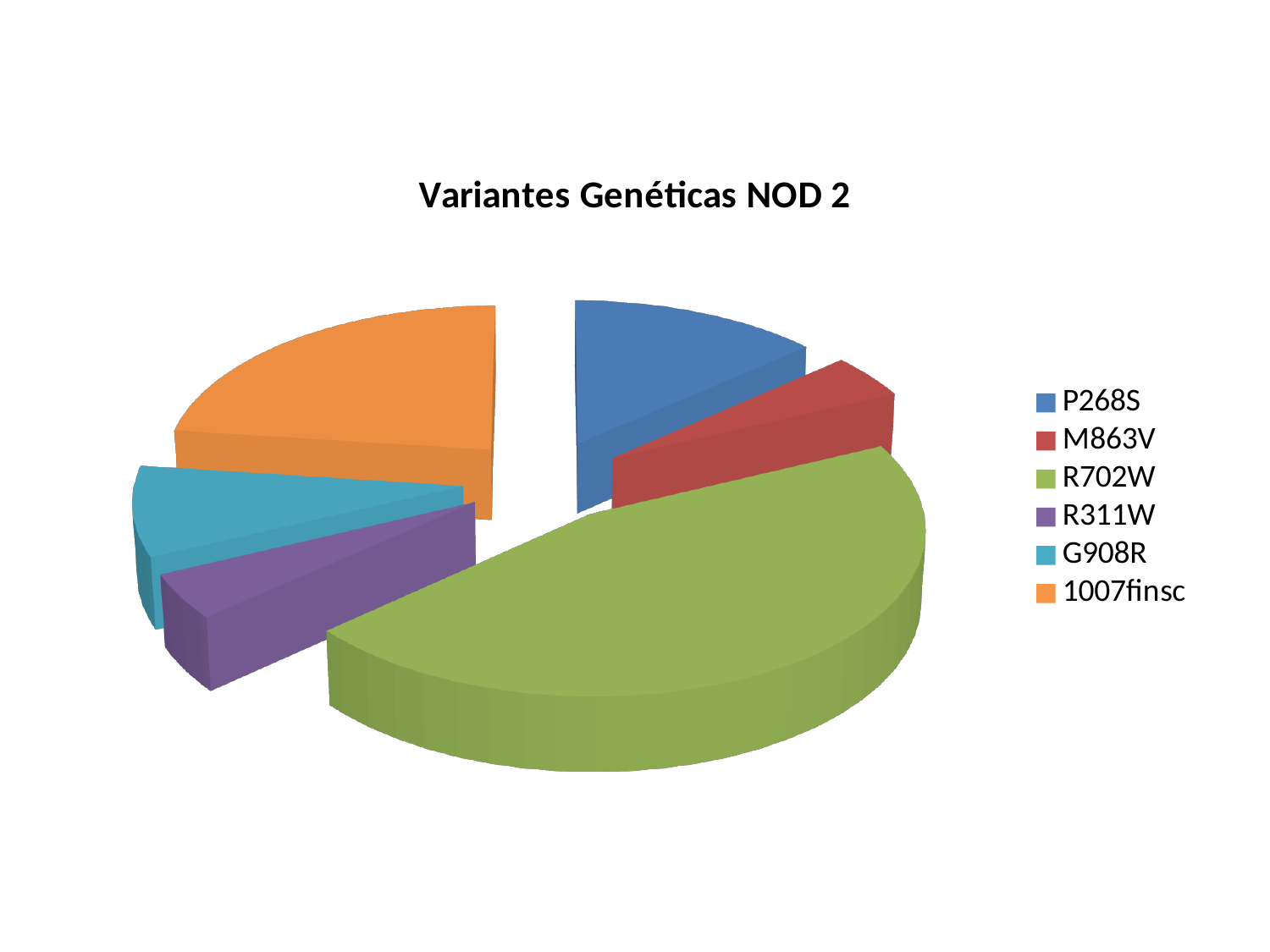
What kind of chart is shown on the slide? pie chart Which slice is larger, R702W or 1007finsc? R702W Which slice is larger, 1007finsc or M863V? 1007finsc What is the title of the chart? Variantes Genéticas NOD 2 Which slice is larger, 1007finsc or G908R? 1007finsc What colour is the slice for R702W in the legend? green Which category has the largest slice of the pie? R702W Which category is listed last in the legend? 1007finsc How many categories (slices) does the pie chart have? 6